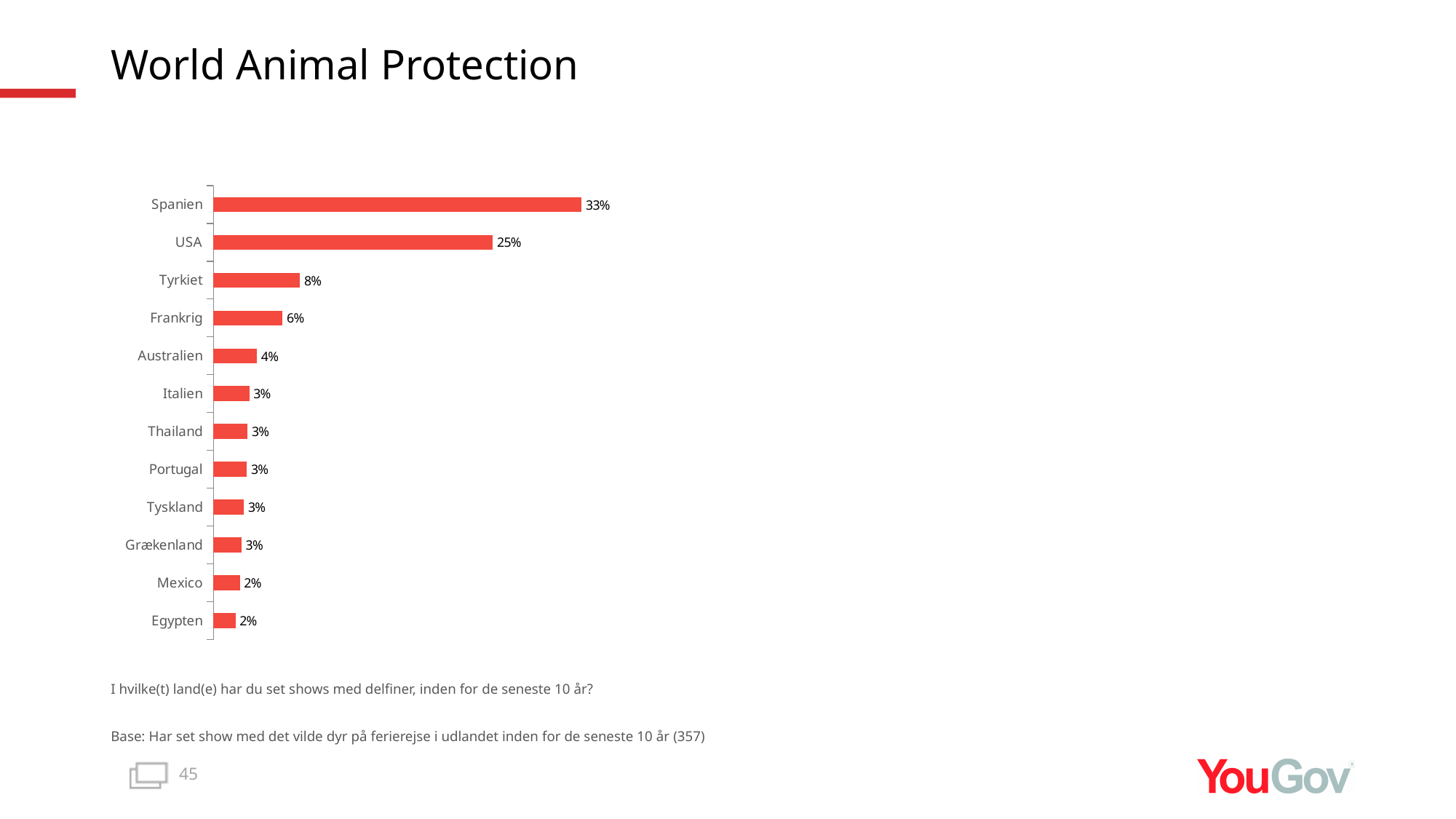
What is the value for Australien? 4% Which has a larger value, USA or Tyrkiet? USA What kind of chart is shown on the slide? Bar chart How many countries are shown in the chart? 12 Which has a larger value, Frankrig or Australien? Frankrig What is the difference between the values for Tyrkiet and Frankrig? 2% What is the value for Spanien? 33% What is the value for USA? 25% What colour are the bars in the chart? Red What is the difference between the values for Spanien and USA? 8% Which country has the highest value? Spanien What is the value for Tyrkiet? 8%